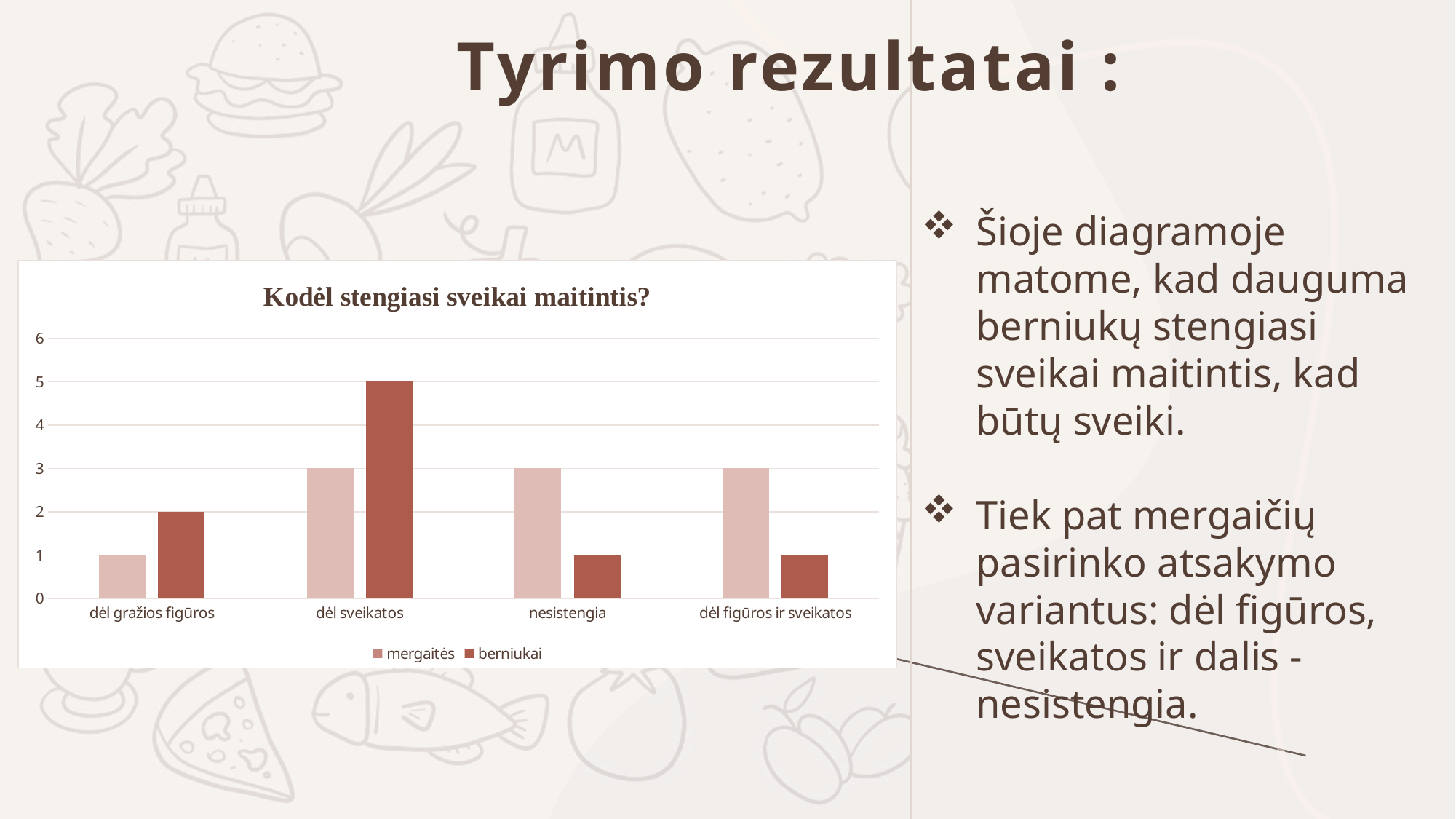
Which category has the lowest value for mergaitės? dėl gražios figūros What kind of chart is shown on the slide? bar chart In the category dėl figūros ir sveikatos, which series has the larger value, mergaitės or berniukai? mergaitės What is the value for mergaitės in the category dėl gražios figūros? 1 How many categories are shown on the x axis? 4 What is the title of the chart? Kodėl stengiasi sveikai maitintis? Is the value for berniukai in the category dėl sveikatos greater or less than 4? greater Which category has the highest value for berniukai? dėl sveikatos What is the value for berniukai in the category nesistengia? 1 How many series does the legend list? 2 What is the value for berniukai in the category dėl sveikatos? 5 What is the difference between the berniukai and mergaitės values in the category dėl sveikatos? 2